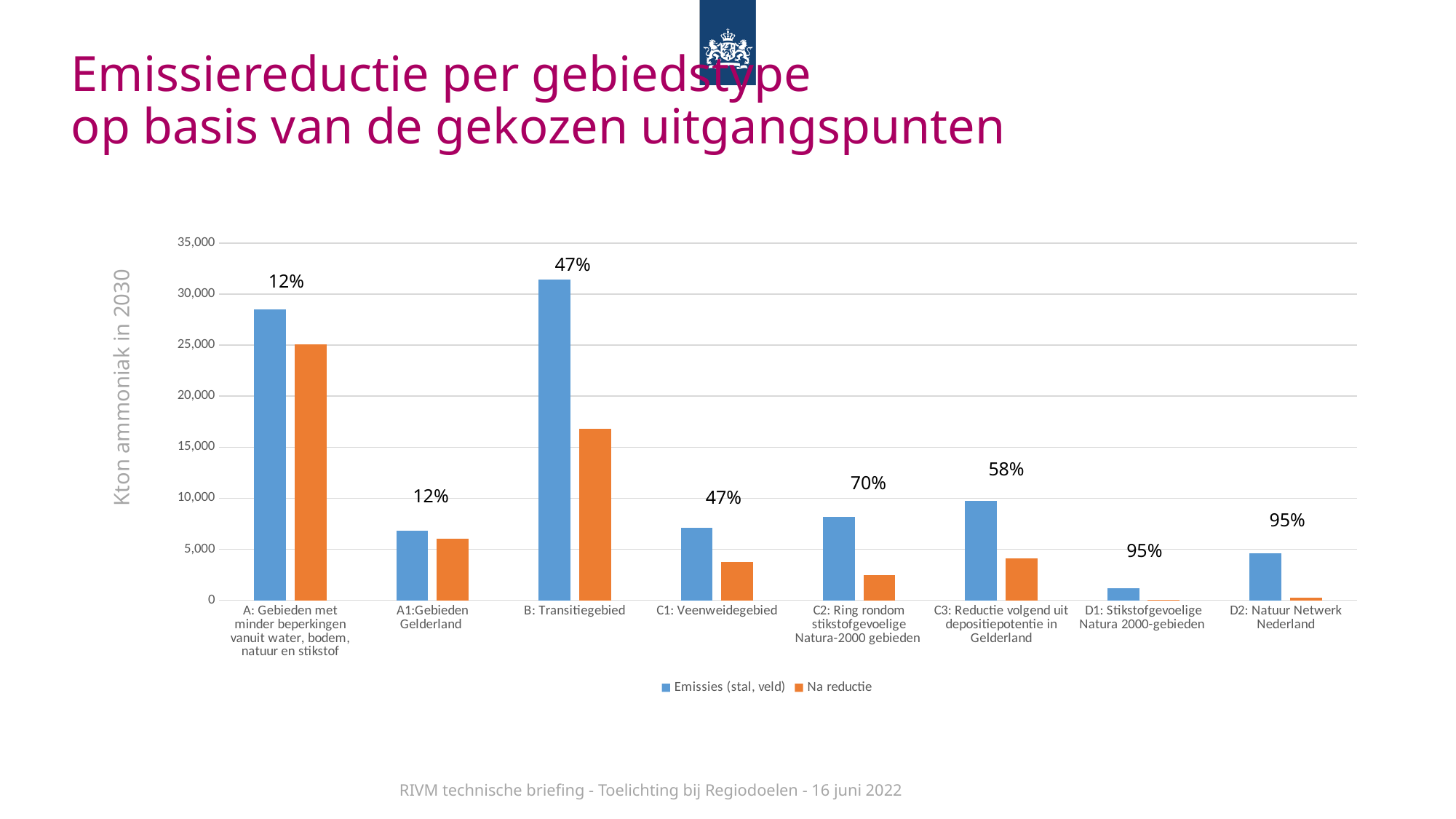
What is the title of the vertical axis? Kton ammoniak in 2030 What percentage label is shown above the bars for C2: Ring rondom stikstofgevoelige Natura-2000 gebieden? 70% What percentage label is shown above the bars for D1: Stikstofgevoelige Natura 2000-gebieden? 95% How many series does the legend list? 2 Which category has the lowest Emissies (stal, veld) value? D1: Stikstofgevoelige Natura 2000-gebieden Which category has the highest Emissies (stal, veld) value? B: Transitiegebied What percentage label is shown above the bars for B: Transitiegebied? 47% How many categories (gebiedstypes) are shown on the x axis? 8 Is the Emissies (stal, veld) value for B: Transitiegebied greater or less than 30,000? greater What percentage label is shown above the bars for C3: Reductie volgend uit depositiepotentie in Gelderland? 58% What kind of chart is shown on the slide? bar chart Is the Na reductie value for B: Transitiegebied greater or less than 15,000? greater